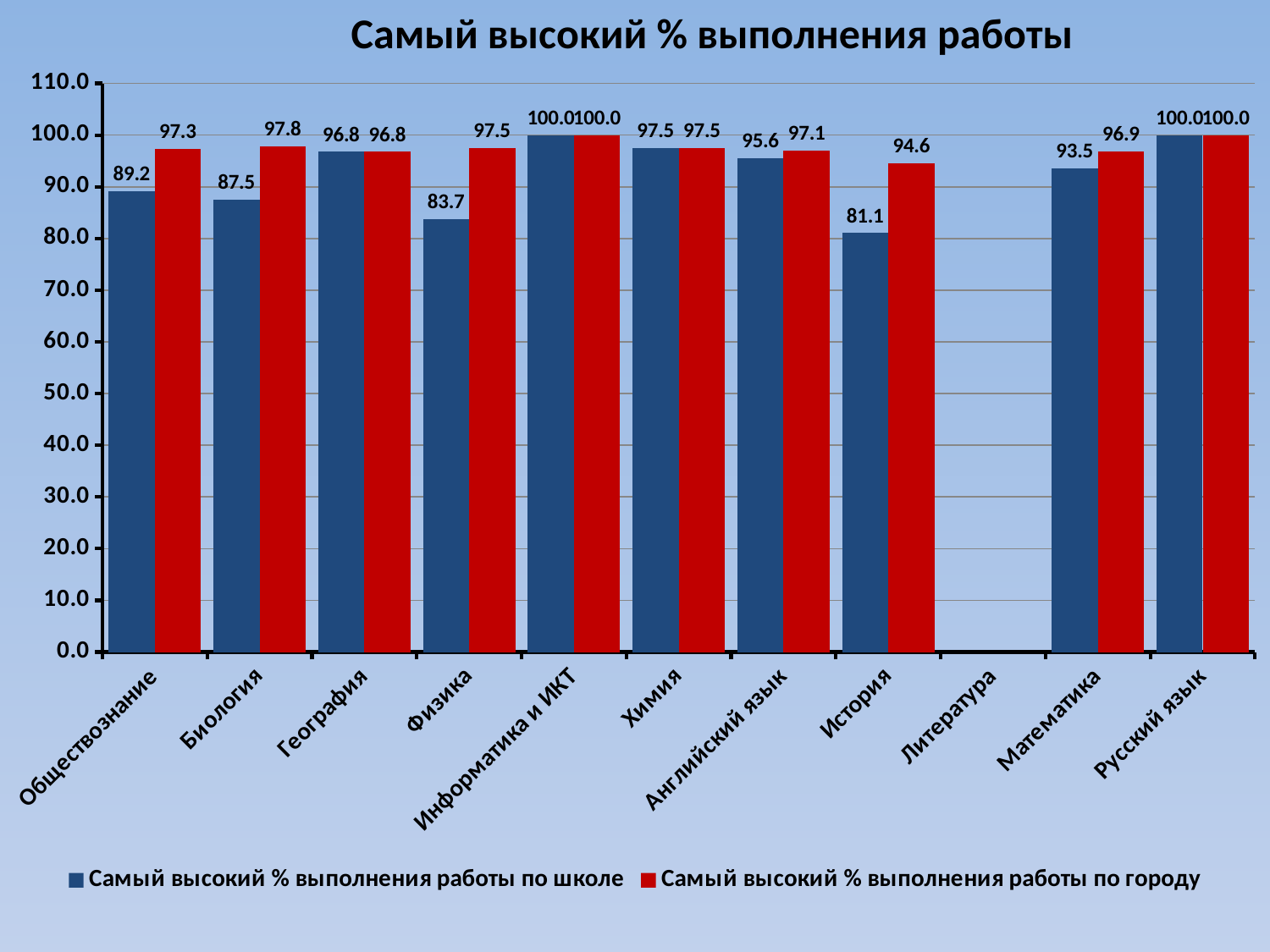
What is the value for История in the series 'Самый высокий % выполнения работы по городу'? 94.6 Which is larger for Математика: the 'по школе' value or the 'по городу' value? по городу What is the difference between the 'по городу' and 'по школе' values for Физика? 13.8 How many categories are shown on the x axis? 11 What is the difference between the 'по городу' and 'по школе' values for Обществознание? 8.1 Which category has the lowest value in the series 'Самый высокий % выполнения работы по школе'? История Which category has the lowest value in the series 'Самый высокий % выполнения работы по городу'? История What is the value for Физика in the series 'Самый высокий % выполнения работы по школе'? 83.7 What is the value for Биология in the series 'Самый высокий % выполнения работы по городу'? 97.8 How many series does the legend list? 2 What kind of chart is shown on the slide? bar chart Is the 'по школе' value for История greater or less than 90.0? less